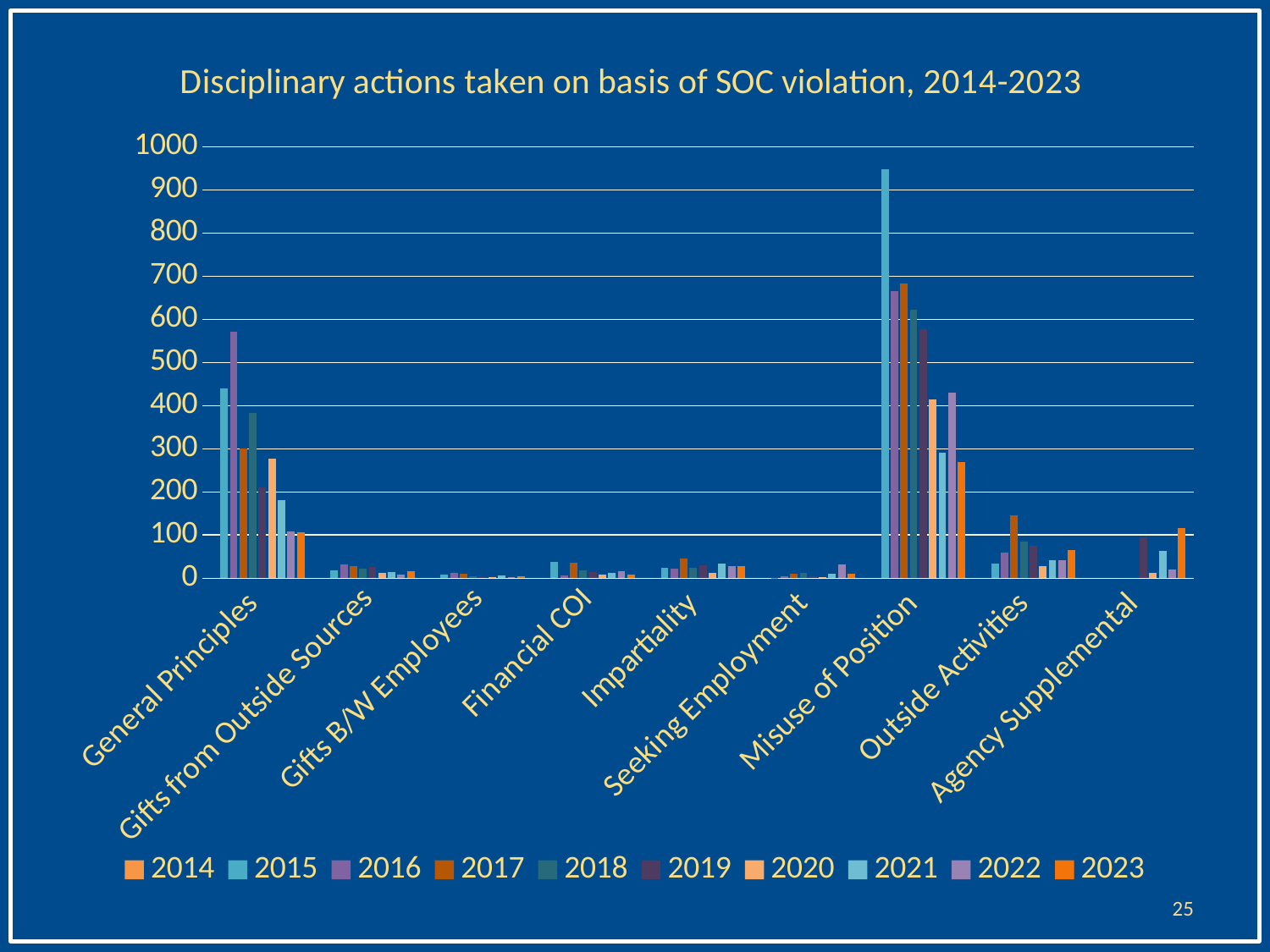
Is the value for 2016 in General Principles greater or less than 500? greater How many series does the legend list? 10 Is the value for 2017 in Outside Activities greater or less than 100? greater How many categories are shown along the x axis? 9 Within the General Principles category, which year has the highest value? 2016 In General Principles, which is larger: the 2015 value or the 2016 value? 2016 What is the title of the chart? Disciplinary actions taken on basis of SOC violation, 2014-2023 Within the Misuse of Position category, which year has the highest value? 2015 Is the value for 2015 in Misuse of Position greater or less than 900? greater What kind of chart is shown on the slide? bar chart Within Misuse of Position, do the values rise or fall from 2017 to 2021? fall Which category contains the tallest bar in the chart? Misuse of Position